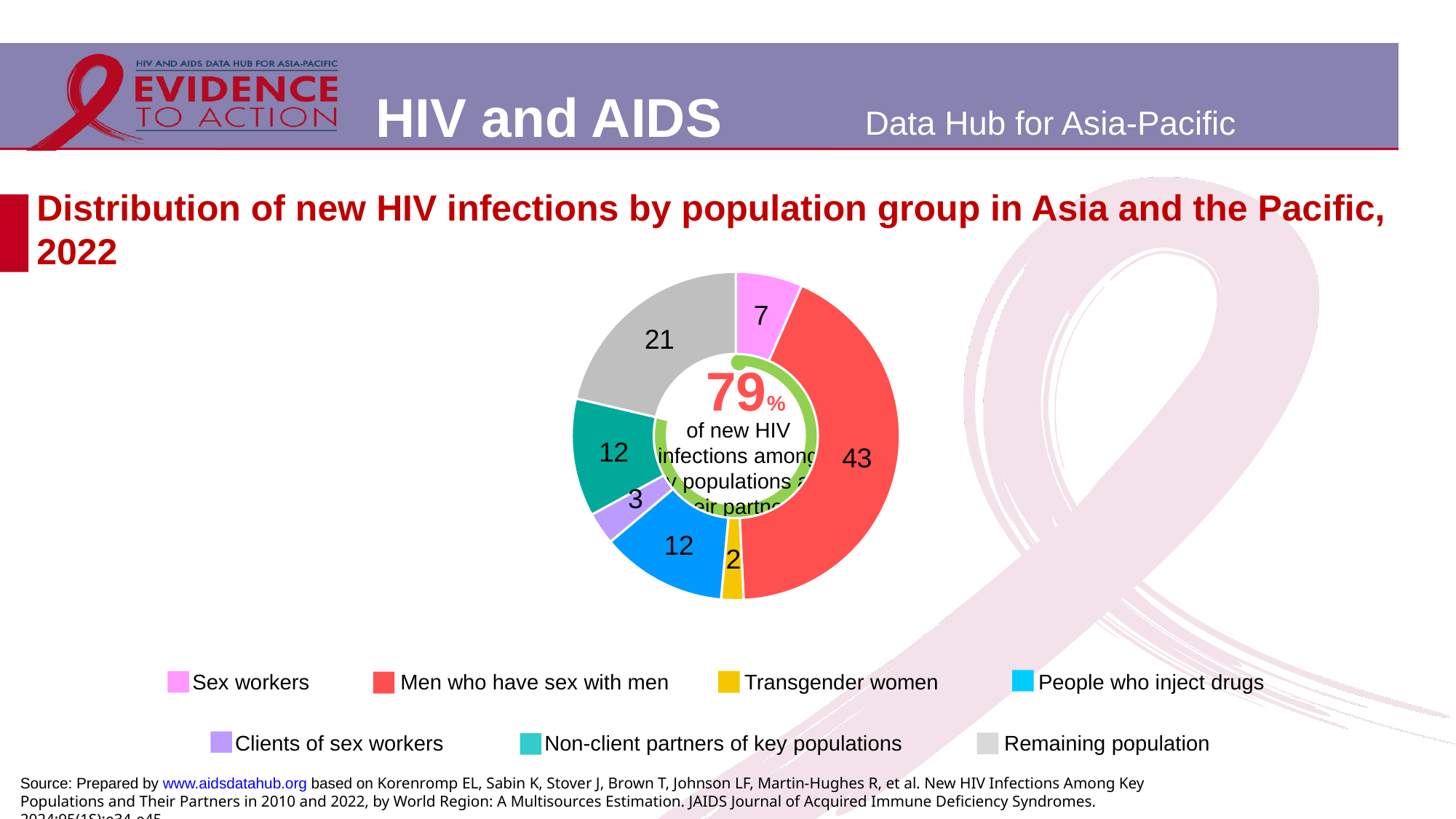
What value is shown for the Remaining population slice? 21 Which is larger, the value for Sex workers or the value for People who inject drugs? People who inject drugs Which population group has the smallest slice of the chart? Transgender women What value is shown for Sex workers? 7 What value is shown for Clients of sex workers? 3 What value is shown for Men who have sex with men in the chart? 43 What percentage is printed in the centre of the chart? 79% What value is shown for Transgender women? 2 What kind of chart is shown on the slide? Donut (pie) chart How many population groups does the legend list? 7 What is the difference between the values for Men who have sex with men and Remaining population? 22 Which population group has the largest slice of the chart? Men who have sex with men